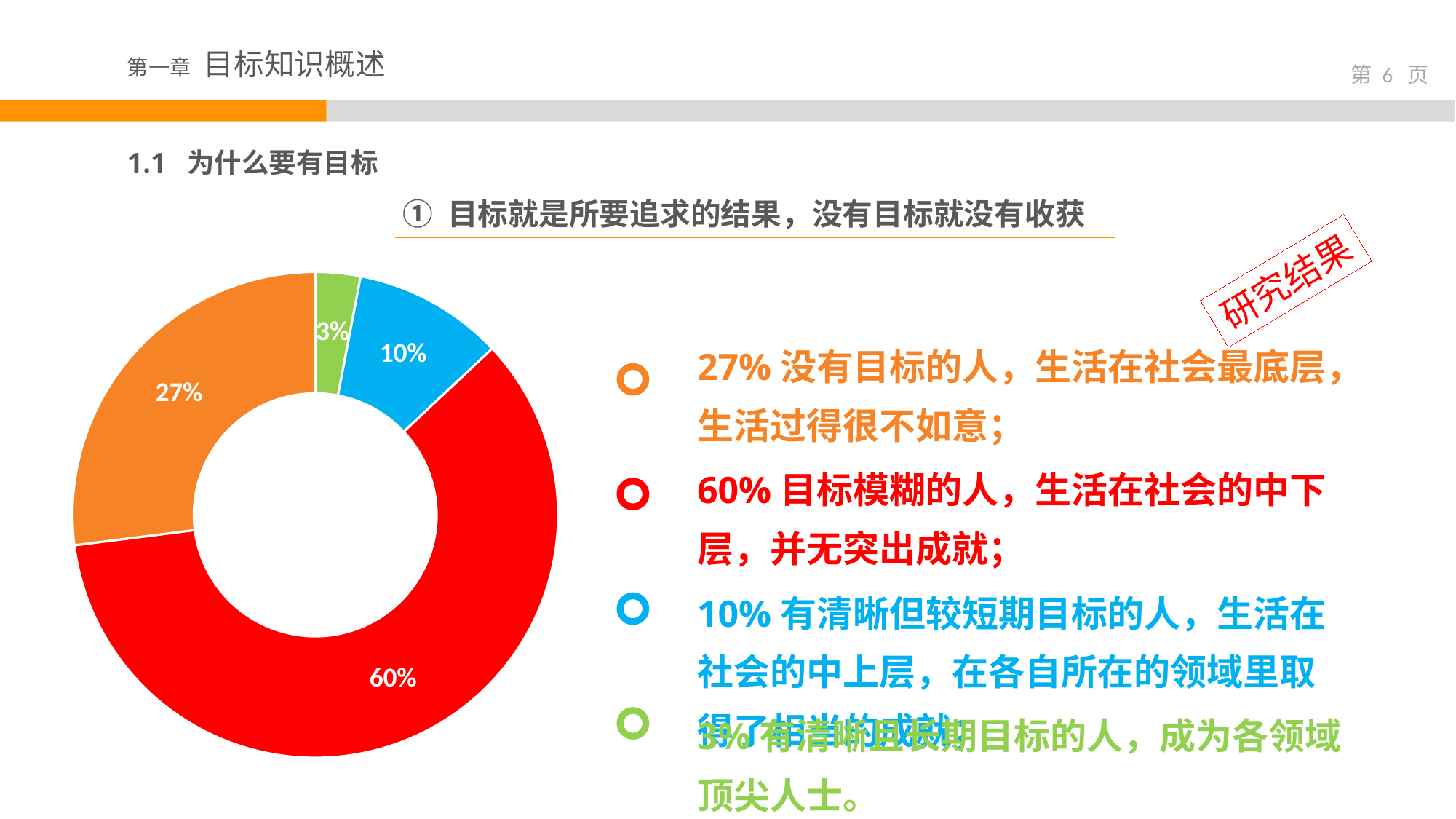
Which is larger in the donut chart, the blue slice or the green slice? The blue slice (10%) What percentage is shown on the red slice of the donut chart? 60% What percentage is shown on the blue slice of the donut chart? 10% According to the slide, what share of people have no goals (没有目标的人)? 27% What kind of chart is shown on the slide? Donut (pie) chart Which slice of the donut chart is the smallest? The green slice (3%, 有清晰且长期目标的人) What percentage is shown on the green slice of the donut chart? 3% Which slice of the donut chart is the largest? The red slice (60%, 目标模糊的人) What colour is used for the 10% slice in the donut chart? Blue What percentage is shown on the orange slice of the donut chart? 27% What is the difference between the red slice (60%) and the orange slice (27%) in the donut chart? 33% How many slices does the donut chart have? 4